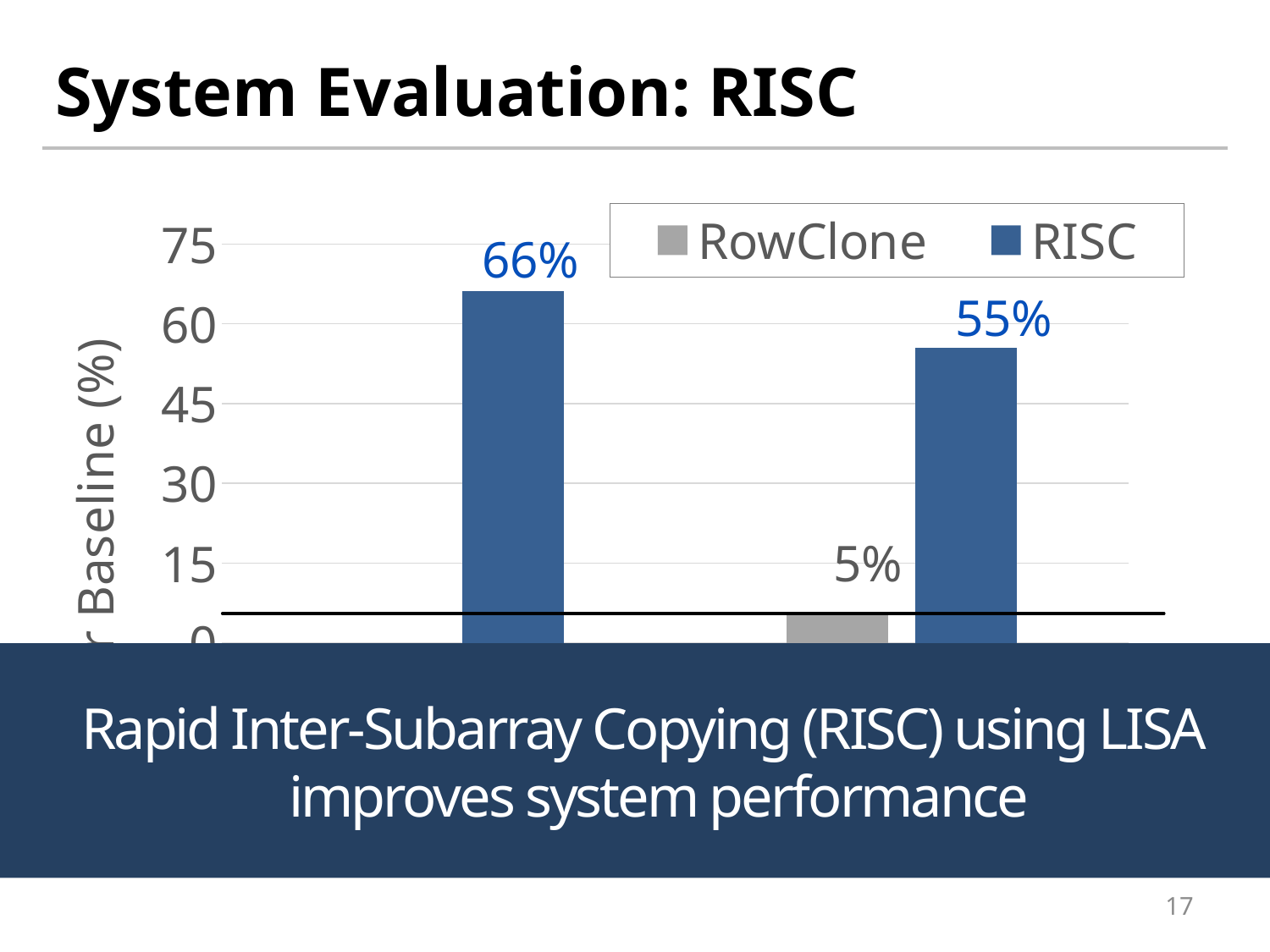
What is the difference between the RISC value in the left group (66%) and the RISC value in the right group (55%)? 11% How many series does the chart's legend list? 2 What kind of chart is shown on the slide? bar chart In the right group of bars, which series has the larger value, RowClone or RISC? RISC Which labeled bar has the lowest value on the chart? RowClone in the right group (5%) Is the RISC value in the left group greater or less than 60? greater What are the two series named in the chart's legend? RowClone and RISC In the right group of bars, how much higher is the RISC value than the RowClone value? 50% What is the labeled value of the RowClone bar in the right group of bars? 5% What is the labeled value of the RISC bar in the right group of bars? 55% Which labeled bar has the highest value on the chart? RISC in the left group (66%) What is the labeled value of the RISC bar in the left group of bars? 66%